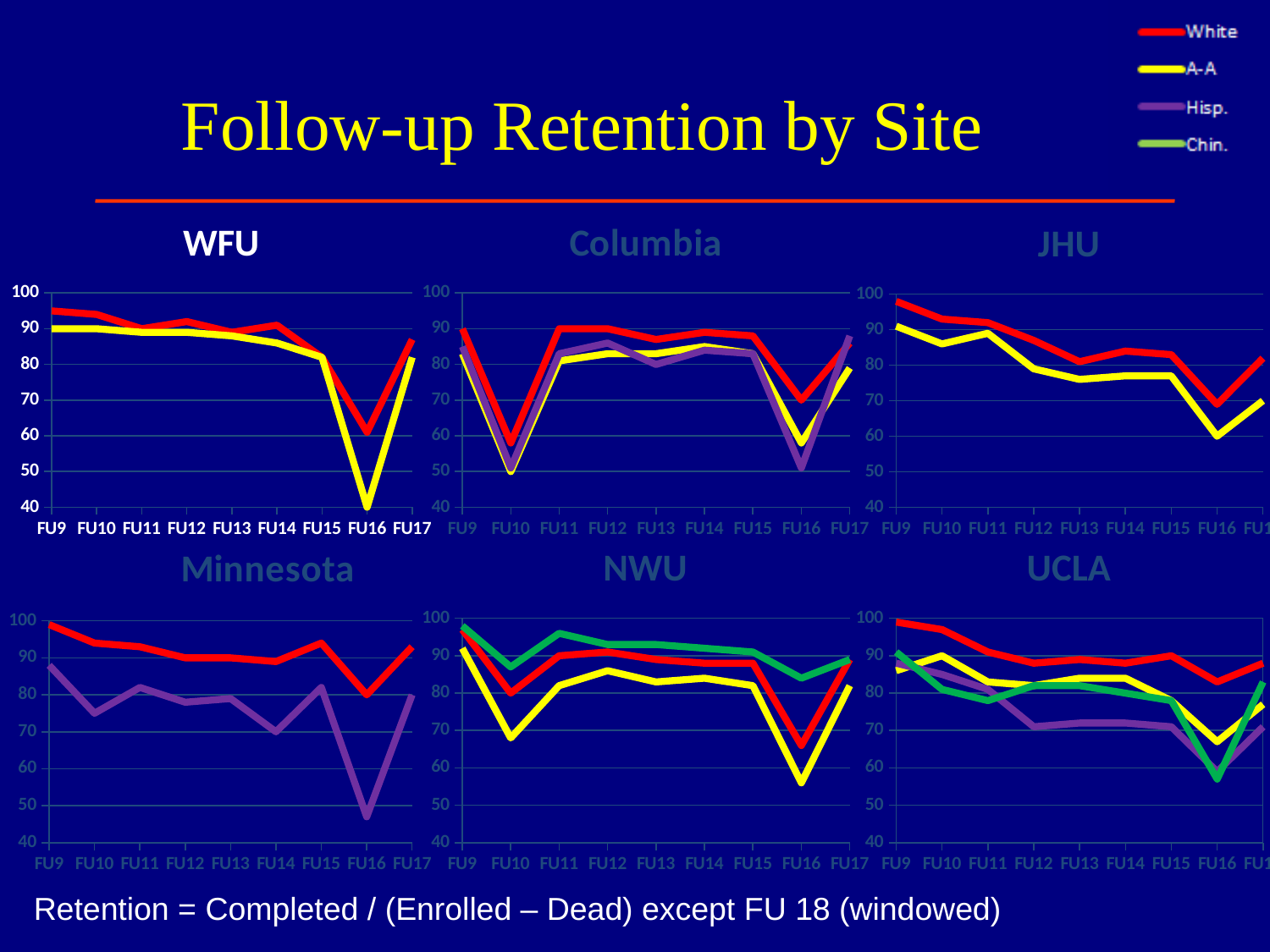
In the WFU chart, how many lines are plotted? 2 In the WFU chart, at which follow-up is the A-A line at its lowest? FU16 In the WFU chart, is the A-A value at FU16 greater or less than 50? less In the UCLA chart, how many lines are plotted? 4 In the WFU chart, how many follow-up points are shown on the x axis? 9 In the JHU chart, which is higher at FU9, the White line or the A-A line? White In the Columbia chart, at which follow-up is the White line at its lowest? FU10 In the Minnesota chart, is the Hisp. value at FU16 greater or less than 60? less What kind of chart is used for each site on the slide? Line chart How many series does the legend in the top-right corner list? 4 In the JHU chart, is the White value at FU9 greater or less than 90? greater In the NWU chart, which series has the lowest value at FU16? A-A